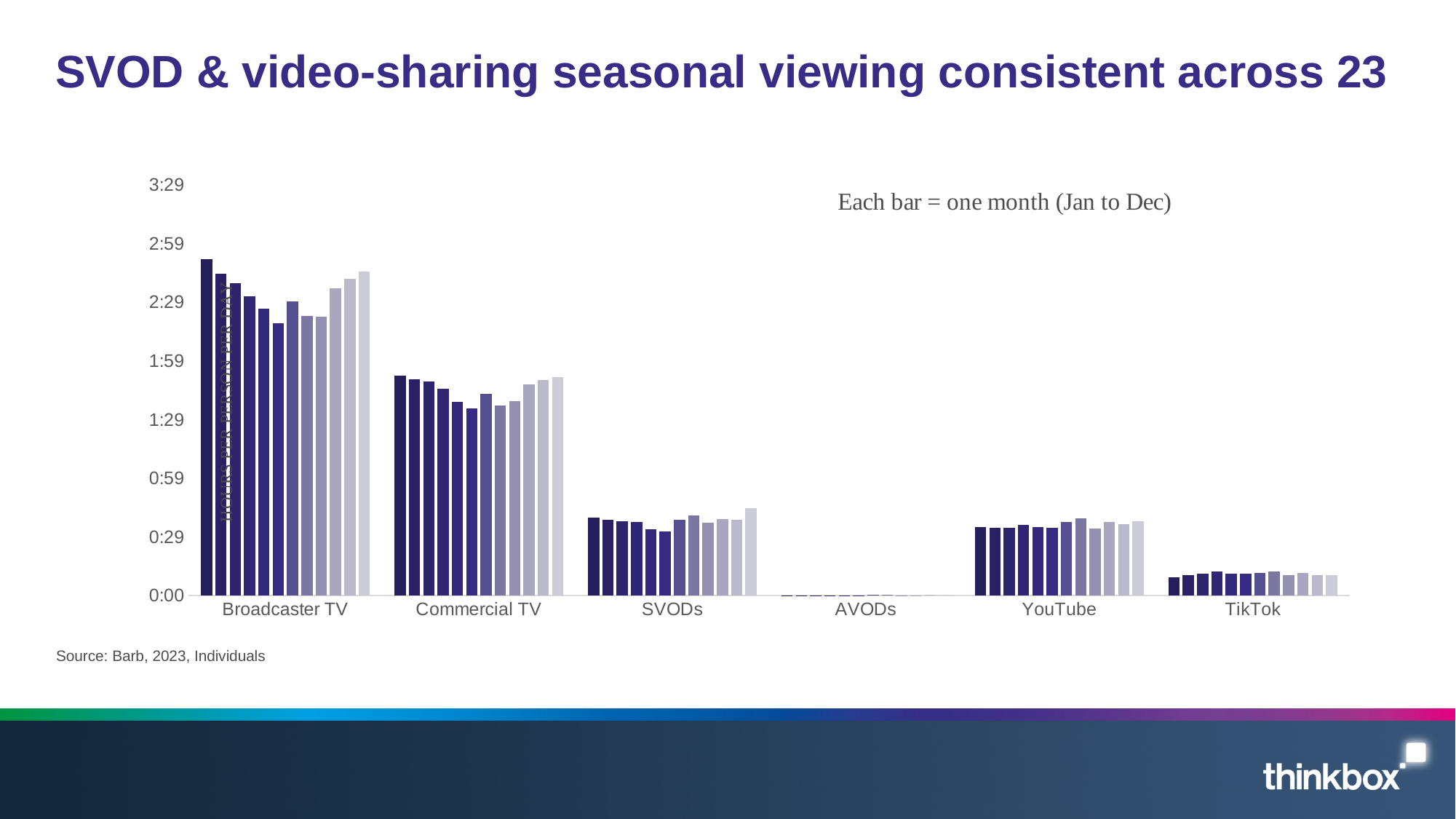
Which category has the lowest viewing values in the chart? AVODs How many categories are shown along the x axis of the chart? 6 What is the source cited for the chart? Barb, 2023, Individuals Which category has higher bars, Commercial TV or SVODs? Commercial TV What kind of chart is shown on the slide? Bar chart Which category has higher bars, YouTube or TikTok? YouTube According to the note on the chart, what does each bar represent? One month (Jan to Dec) Which category has the highest viewing values in the chart? Broadcaster TV Is the December value for SVODs greater or less than 0:59? less Is the January value for TikTok greater or less than 0:29? less Is the January value for Broadcaster TV greater or less than 2:29? greater